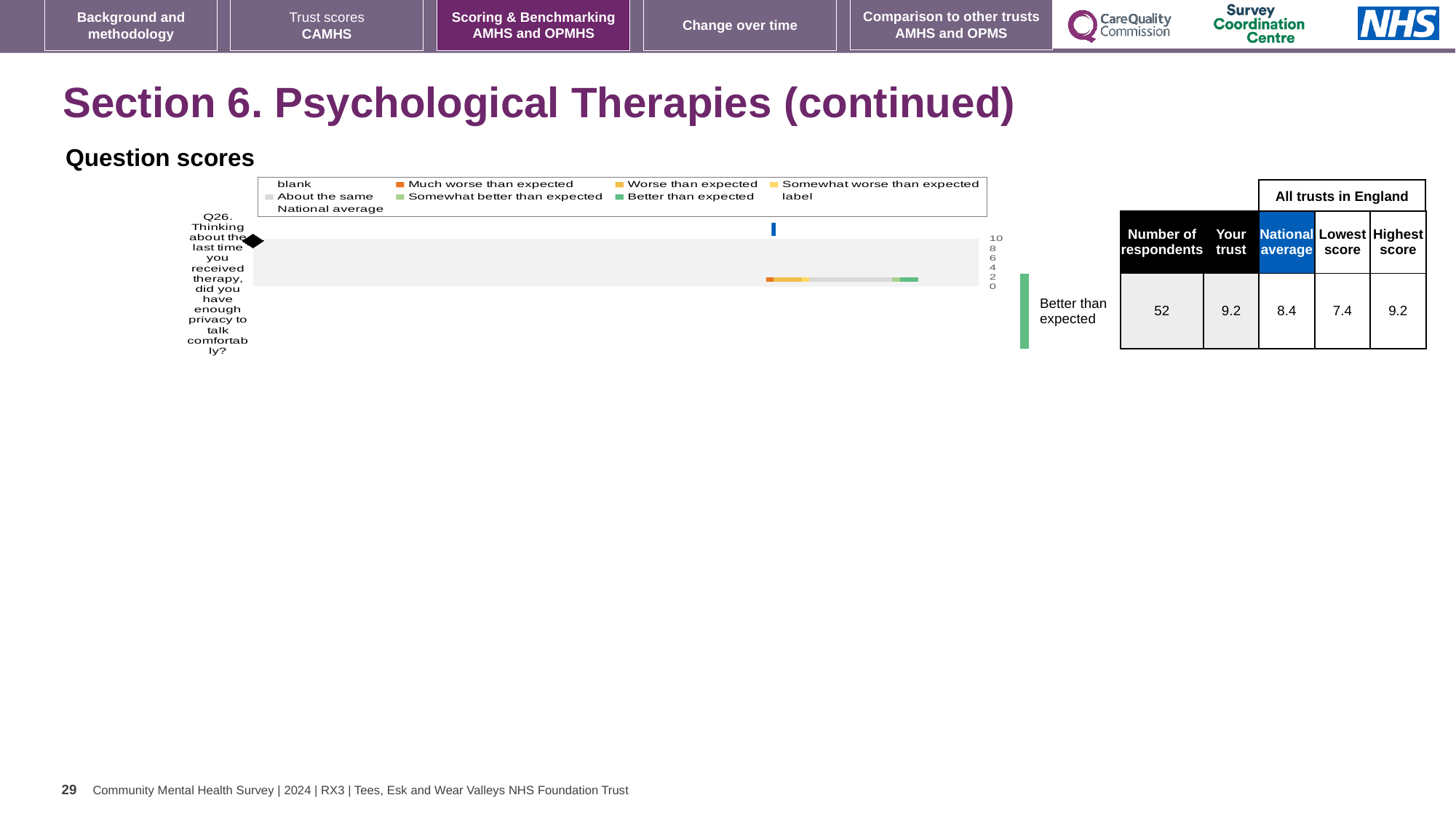
How many survey questions are plotted on the chart? 1 What is the highest value shown on the chart's score axis? 10 What is the 'Your trust' score for Q26 in the table? 9.2 What kind of chart is used to show the Q26 question score? bar chart What is the national average score for Q26? 8.4 What is the difference between the highest and lowest scores for Q26 across all trusts in England? 1.8 How many respondents answered Q26? 52 Which benchmarking category is shown beside the chart for Q26? Better than expected What is the highest score among all trusts in England for Q26? 9.2 Which is larger for Q26, the 'Your trust' score or the national average? Your trust What is the difference between the 'Your trust' score and the national average for Q26? 0.8 What is the lowest score among all trusts in England for Q26? 7.4